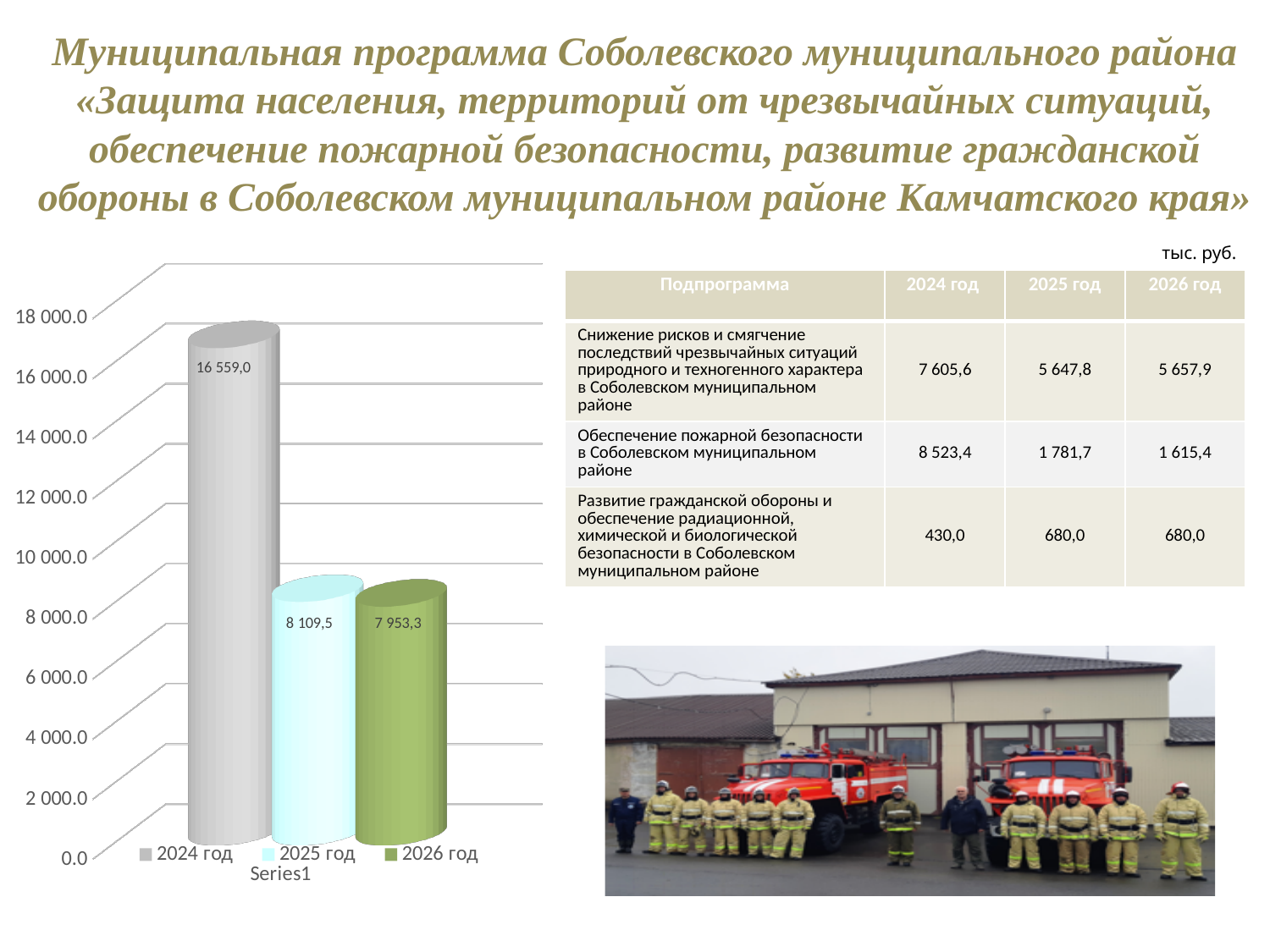
Which year has the highest value in the bar chart? 2024 год What is the value shown for 2026 год in the bar chart? 7 953,3 Which year has the lowest value in the bar chart? 2026 год What is the difference between the values for 2025 год and 2026 год in the bar chart? 156,2 What is the value shown for 2024 год in the bar chart? 16 559,0 How many series does the legend of the bar chart list? 3 What is the value shown for 2025 год in the bar chart? 8 109,5 What kind of chart is shown on the left of the slide? bar chart Is the value for 2024 год in the bar chart greater or less than 16 000.0? greater What is the difference between the values for 2024 год and 2025 год in the bar chart? 8 449,5 Do the values in the bar chart rise or fall from 2024 год to 2026 год? fall In the bar chart, which is larger: the value for 2025 год or the value for 2026 год? 2025 год